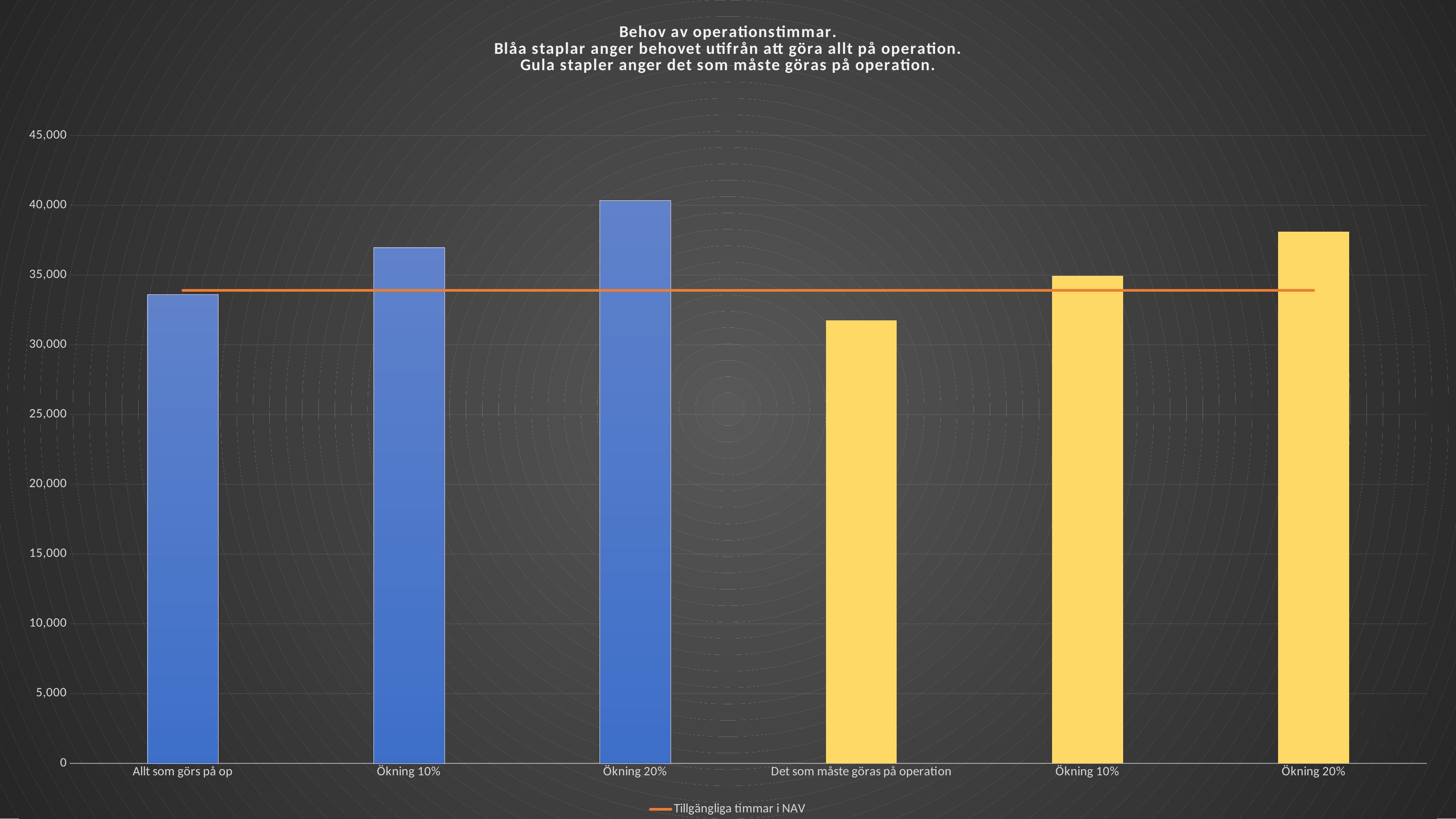
Is the value of the 'Det som måste göras på operation' bar greater or less than 35,000? less Is the value of the blue 'Ökning 10%' bar greater or less than 35,000? greater Which bar is the highest in the chart? Ökning 20% (blue bar) Is the value of the 'Allt som görs på op' bar greater or less than 35,000? less Which bar is the lowest in the chart? Det som måste göras på operation Do the three blue bars rise or fall from left to right? rise Which is larger, the blue 'Ökning 20%' bar or the yellow 'Ökning 20%' bar? the blue 'Ökning 20%' bar What is the name of the series shown in the chart legend? Tillgängliga timmar i NAV What kind of chart is shown on the slide? combination bar and line chart How many bars are plotted in the chart? 6 How many entries does the chart legend list? 1